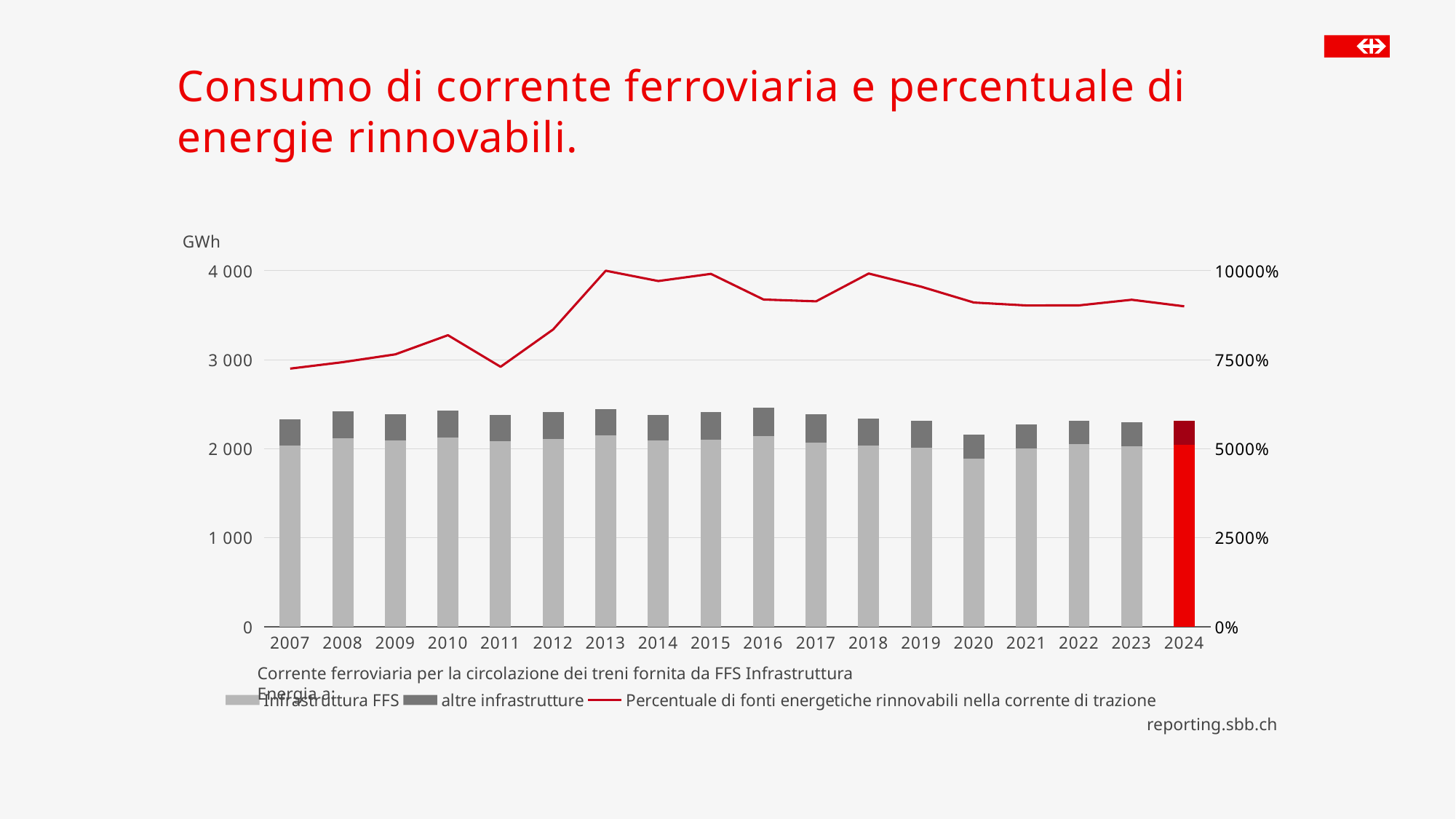
Which year has the lowest total bar (rail current consumption)? 2020 Is the total bar for 2020 greater or less than 3 000 GWh? less What kind of chart is shown on the slide? A combined bar and line chart How many years are shown on the x axis of the chart? 18 Which year's bar is highlighted in red? 2024 What is the title of the slide? Consumo di corrente ferroviaria e percentuale di energie rinnovabili. Is the total bar for 2016 greater or less than 2 000 GWh? greater Does the red line rise or fall between 2011 and 2013? rise Which year has the larger total bar, 2016 or 2020? 2016 Is the value of the red line (Percentuale di fonti energetiche rinnovabili) for 2013 greater or less than 7500%? greater How many series does the chart legend list? 3 Which year has the higher value on the red line, 2011 or 2013? 2013